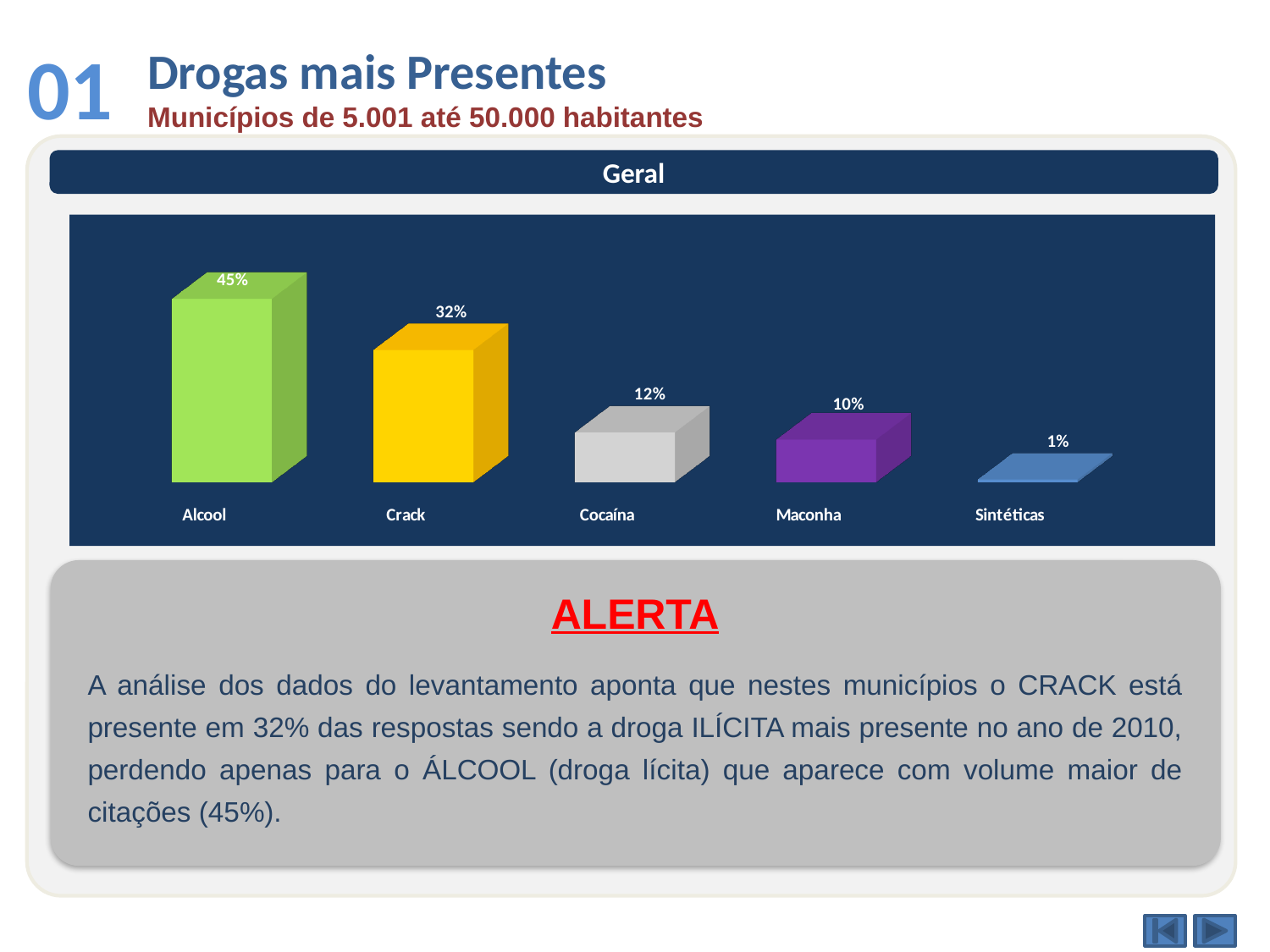
What is the value for Alcool? 45% Which is larger, the value for Cocaína or the value for Maconha? Cocaína How many categories are shown in the chart? 5 Which category has the highest value? Alcool What is the value for Maconha? 10% What is the value for Crack? 32% What is the value for Cocaína? 12% What is the title shown in the header bar above the chart? Geral What is the difference between the values for Alcool and Crack? 13% What kind of chart is shown on the slide? Bar chart Which category has the lowest value? Sintéticas What is the value for Sintéticas? 1%